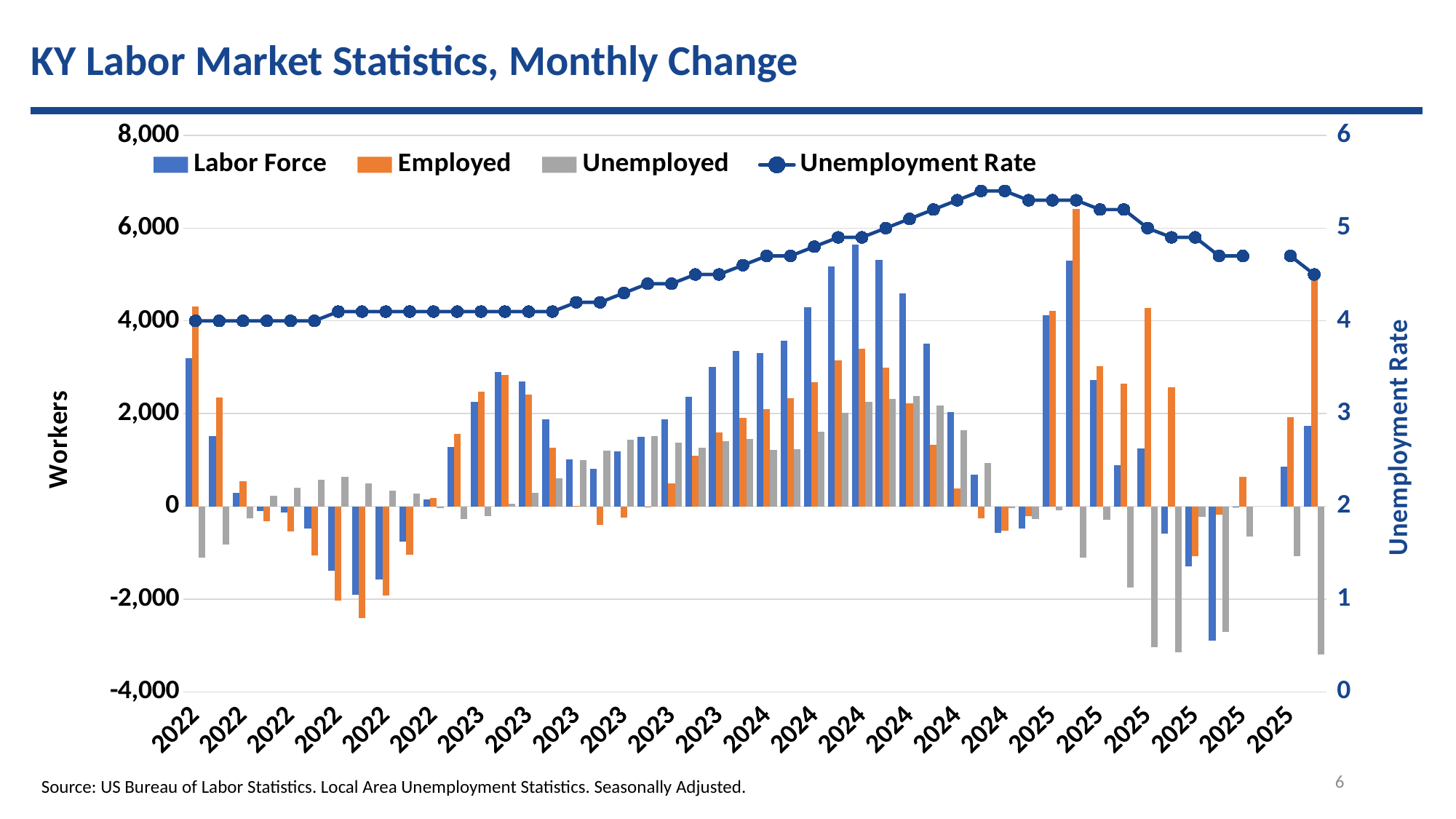
Which series has the single tallest bar on the chart? Employed Is the tallest Labor Force bar greater or less than 6,000? less How many series does the legend list? 4 Does the Unemployment Rate line rise or fall from its 2024 peak to the end of the chart in 2025? fall Is the highest point of the Unemployment Rate line greater or less than 5? greater Does the Unemployment Rate line rise or fall from the start of 2022 to its peak in 2024? rise What is the title of the chart? KY Labor Market Statistics, Monthly Change Is the lowest Unemployed bar greater or less than -2,000? less What is the title of the right-hand vertical axis? Unemployment Rate What kind of chart is shown on the slide? A combination bar and line chart